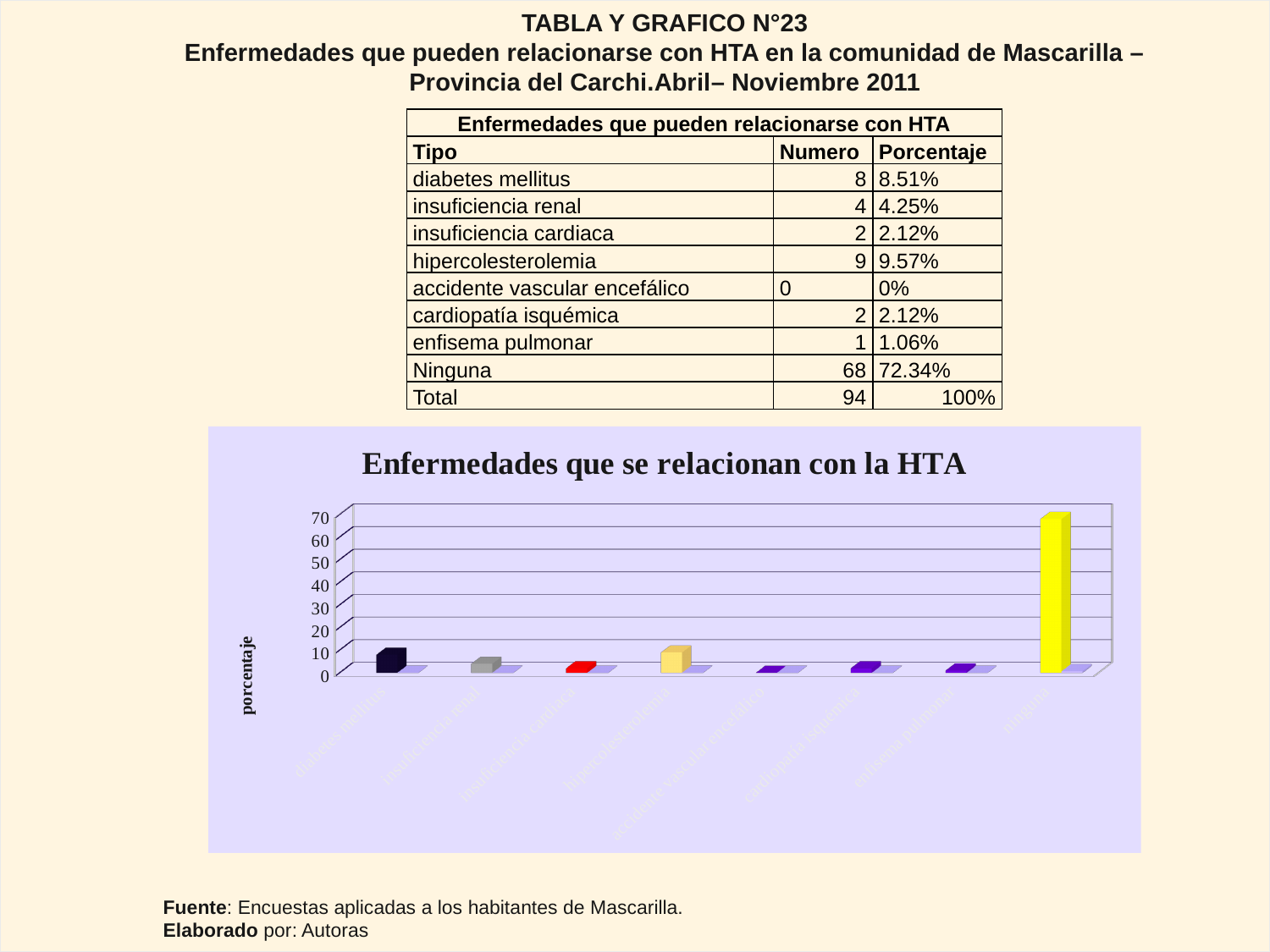
Is the value for hipercolesterolemia greater or less than 20? less What is the difference between the percentage for Ninguna and the percentage for hipercolesterolemia? 62.77% What kind of chart is shown on the slide? bar chart What is the label on the vertical axis of the chart? porcentaje Is the value of the tallest bar (Ninguna) greater or less than 70? greater What percentage is shown for diabetes mellitus? 8.51% Which category has a value of 0% in the chart? accidente vascular encefálico Which is larger, the value for hipercolesterolemia or the value for insuficiencia renal? hipercolesterolemia What percentage is shown for Ninguna? 72.34% What is the title of the chart? Enfermedades que se relacionan con la HTA Which category has the highest bar in the chart? Ninguna How many bars (categories) are plotted in the chart? 8